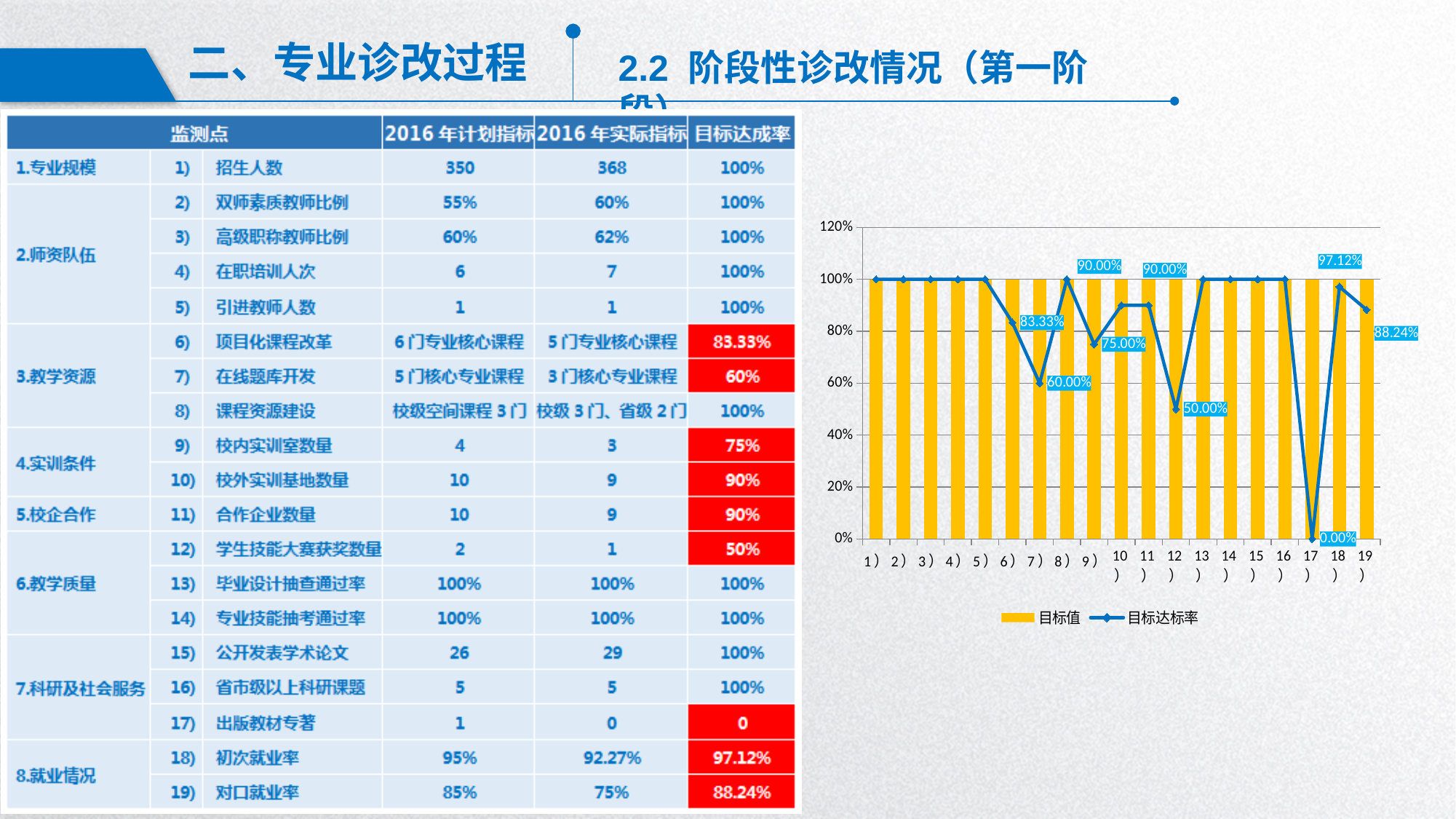
How many series does the chart's legend list? 2 What are the two legend entries of the chart? 目标值 and 目标达标率 In the chart, which has the larger 目标达标率 value, category 7) or category 12)? 7) What kind of chart is shown on the slide? Combined bar and line chart In the chart, what is the 目标达标率 value for category 18)? 97.12% In the chart, is the 目标达标率 value for category 6) greater or less than 80%? greater In the chart, what is the difference between the 目标达标率 values for categories 18) and 19)? 8.88% In the chart, what is the 目标达标率 value for category 7)? 60.00% In the chart, what is the 目标达标率 value for category 19)? 88.24% How many categories are shown on the x axis of the chart? 19 In the chart, what is the 目标达标率 value for category 12)? 50.00% In the chart, which category has the lowest 目标达标率 value? 17)